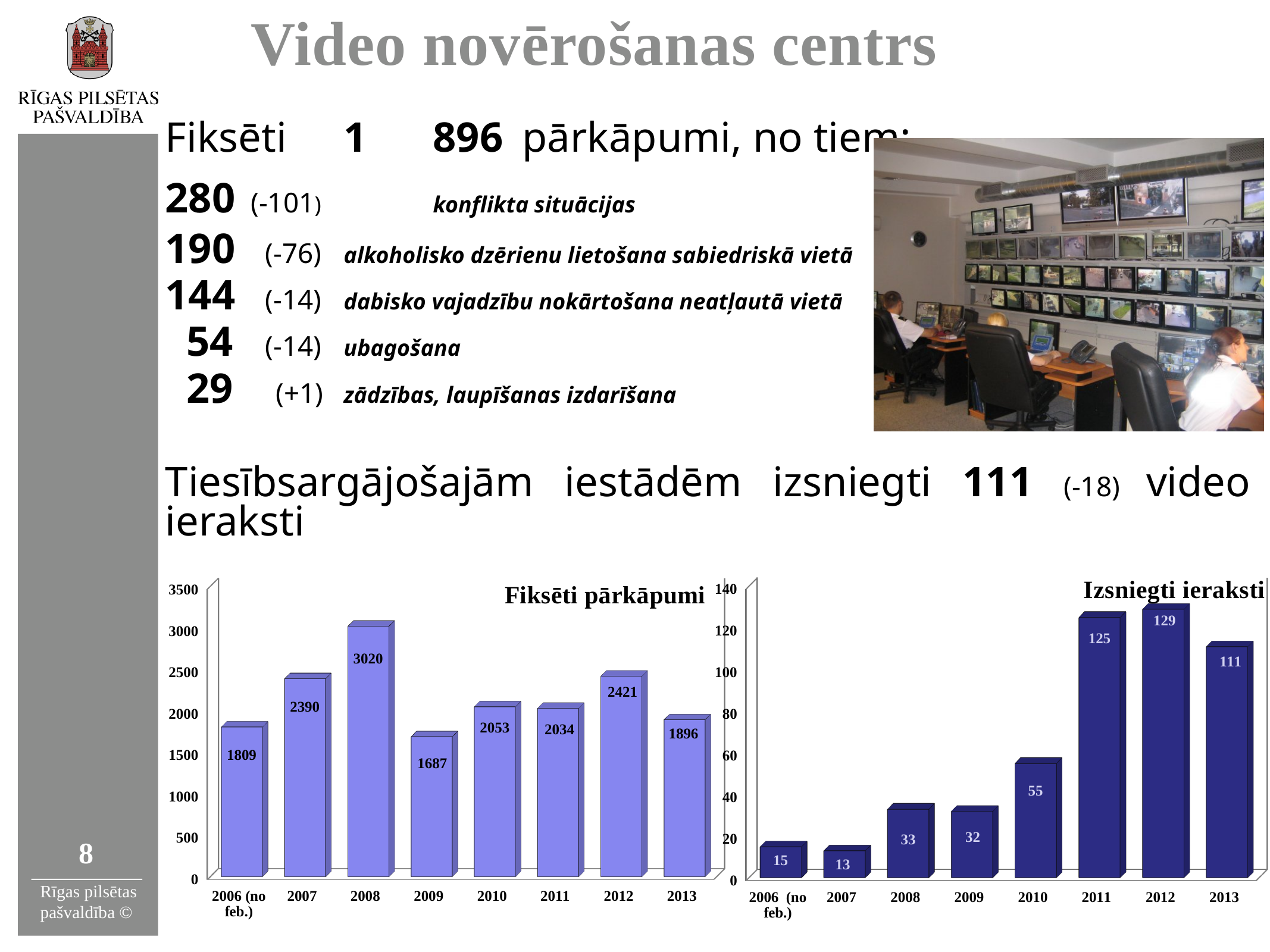
In the 'Fiksēti pārkāpumi' chart, is the value for 2007 greater or less than 2000? greater In the 'Fiksēti pārkāpumi' chart, which year has the lowest value? 2009 In the 'Izsniegti ieraksti' chart, which year has the lowest value? 2007 In the 'Fiksēti pārkāpumi' chart, which year has the highest value? 2008 In the 'Izsniegti ieraksti' chart, which is larger, the value for 2011 or the value for 2013? 2011 What type of chart is the 'Izsniegti ieraksti' chart? bar chart In the 'Izsniegti ieraksti' chart, what is the value for 2010? 55 In the 'Fiksēti pārkāpumi' chart, how many years are shown on the x axis? 8 In the 'Izsniegti ieraksti' chart, which year has the highest value? 2012 In the 'Izsniegti ieraksti' chart, what is the difference between the values for 2012 and 2011? 4 In the 'Fiksēti pārkāpumi' chart, what is the value for 2008? 3020 In the 'Fiksēti pārkāpumi' chart, what is the difference between the values for 2012 and 2013? 525